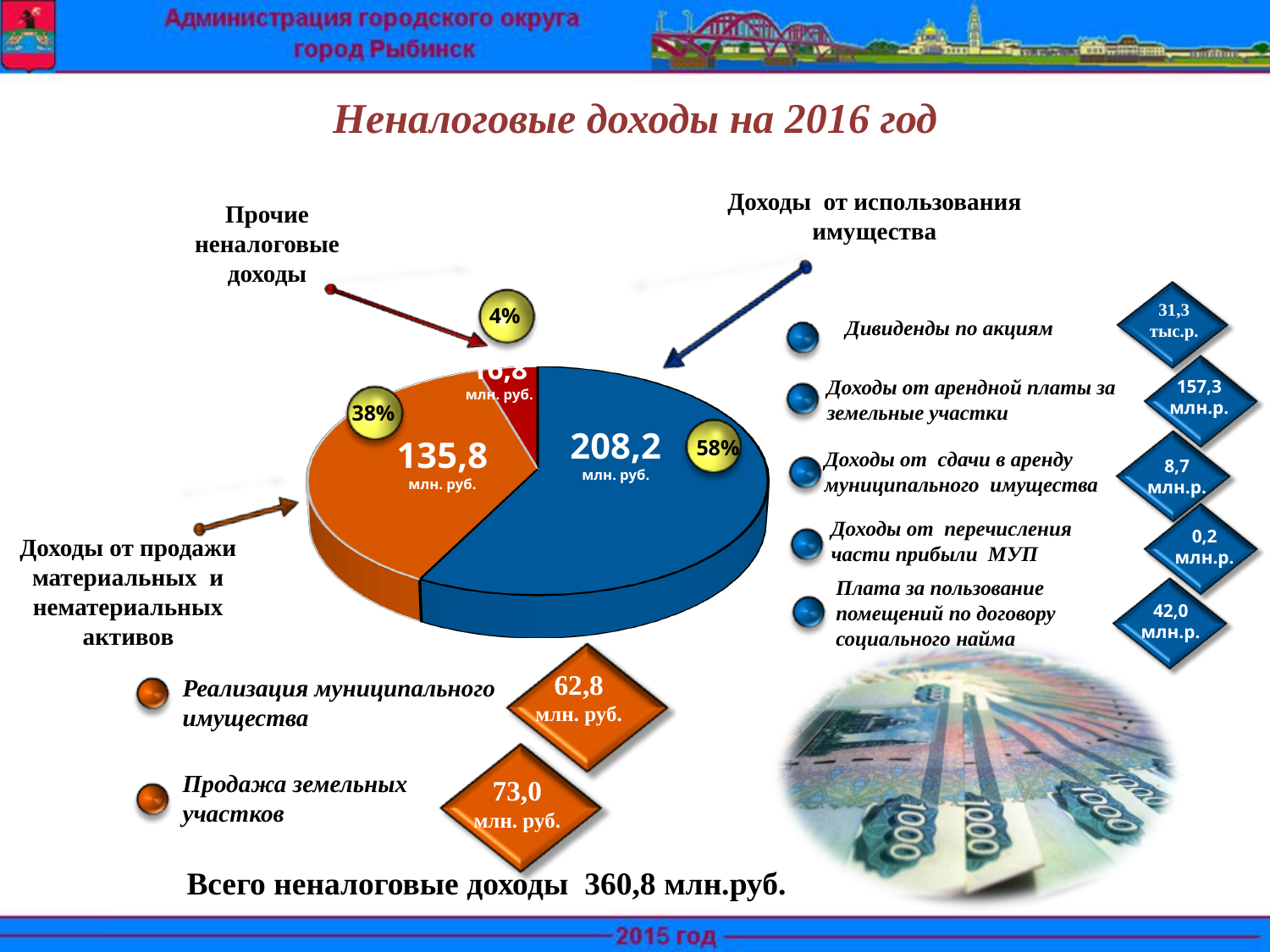
Which slice of the pie chart is the smallest? Прочие неналоговые доходы What is the value shown for the slice 'Доходы от продажи материальных и нематериальных активов'? 135,8 млн. руб. Which slice of the pie chart is the largest? Доходы от использования имущества How many slices does the pie chart have? 3 What is the title of the slide containing the pie chart? Неналоговые доходы на 2016 год What is the value shown for the slice 'Доходы от использования имущества'? 208,2 млн. руб. What share of the pie does 'Доходы от продажи материальных и нематериальных активов' represent? 38% What is the difference in млн. руб. between 'Доходы от использования имущества' (208,2) and 'Доходы от продажи материальных и нематериальных активов' (135,8)? 72,4 млн. руб. What kind of chart is shown on the slide? pie chart What share of the pie does 'Прочие неналоговые доходы' represent? 4% Which is larger: 'Доходы от использования имущества' or 'Доходы от продажи материальных и нематериальных активов'? Доходы от использования имущества What share of the pie does 'Доходы от использования имущества' represent? 58%